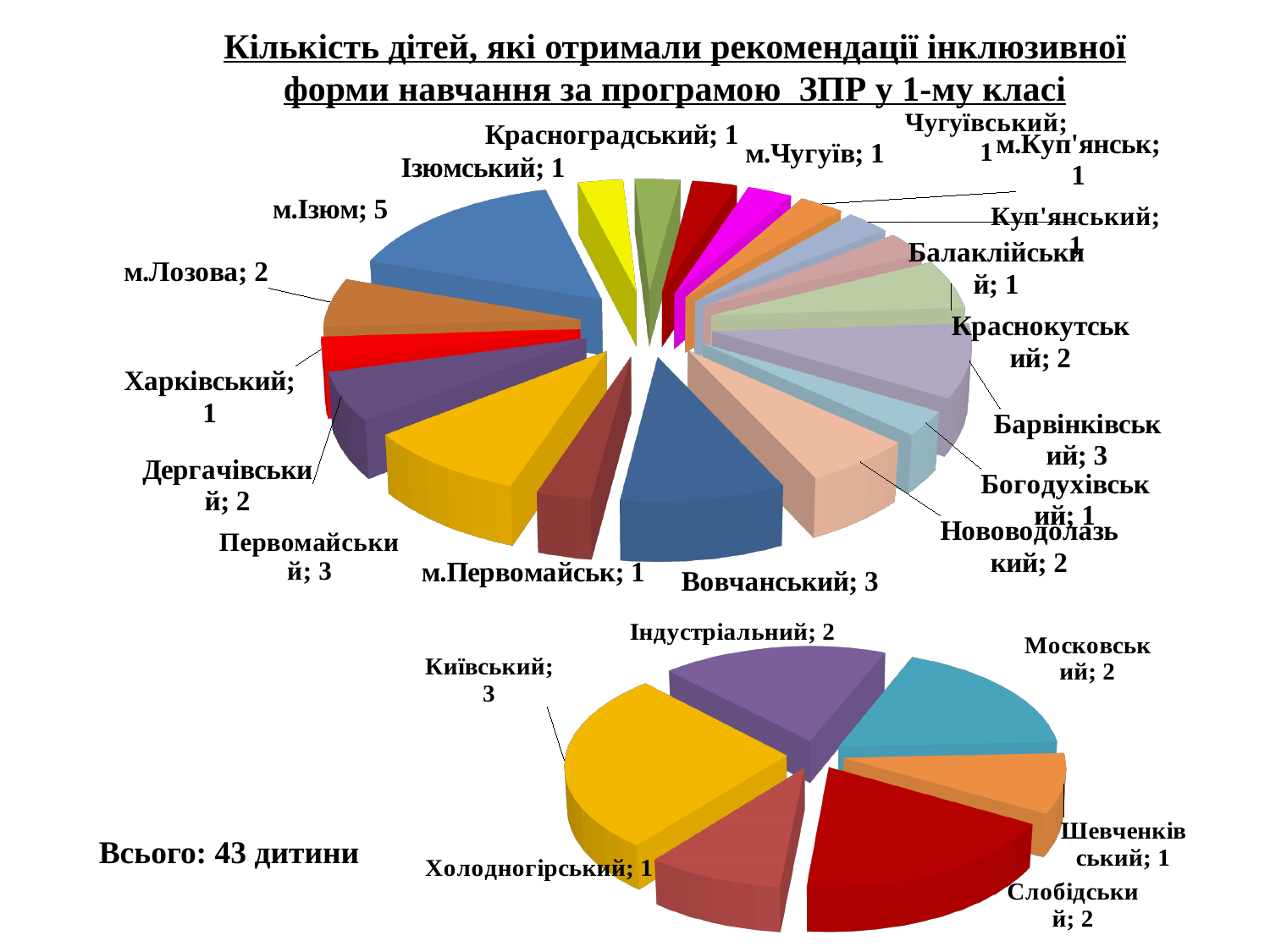
In the top pie chart, what is the value for м.Ізюм? 5 In the bottom pie chart, how many categories are shown? 6 In the top pie chart, what is the value for Вовчанський? 3 In the bottom pie chart, which category has the highest value? Київський According to the slide, what is the total number of children across both charts? 43 дитини In the top pie chart, how many categories are shown? 18 In the bottom pie chart, what is the value for Слобідський? 2 In the top pie chart, which is larger: the value for Первомайський or the value for м.Первомайськ? Первомайський In the bottom pie chart, which is larger: the value for Київський or the value for Холодногірський? Київський In the top pie chart, what is the difference between the values for м.Ізюм and Барвінківський? 2 In the top pie chart, which category has the highest value? м.Ізюм What type of charts are shown on the slide? Pie charts